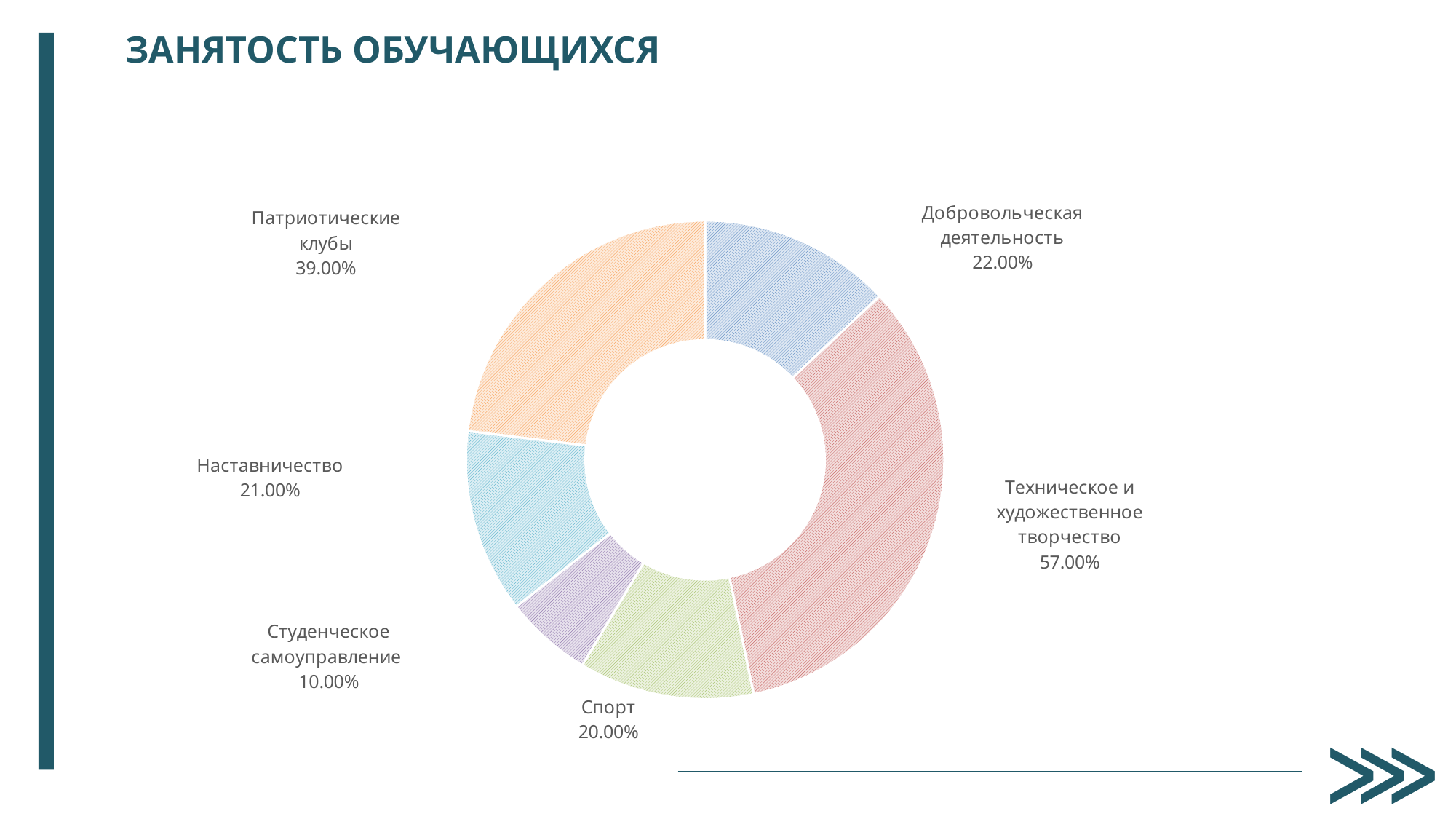
What is the difference between the values for Техническое и художественное творчество and Патриотические клубы? 18.00% Which is larger: the value for Спорт or the value for Студенческое самоуправление? Спорт What is the title of the slide? ЗАНЯТОСТЬ ОБУЧАЮЩИХСЯ What is the value shown for Добровольческая деятельность? 22.00% What is the value shown for Техническое и художественное творчество? 57.00% What is the value shown for Наставничество? 21.00% What is the value shown for Спорт? 20.00% What is the value shown for Патриотические клубы? 39.00% Which category has the lowest value? Студенческое самоуправление What kind of chart is shown on the slide? Doughnut (pie) chart Which category has the highest value? Техническое и художественное творчество How many categories are shown in the chart? 6